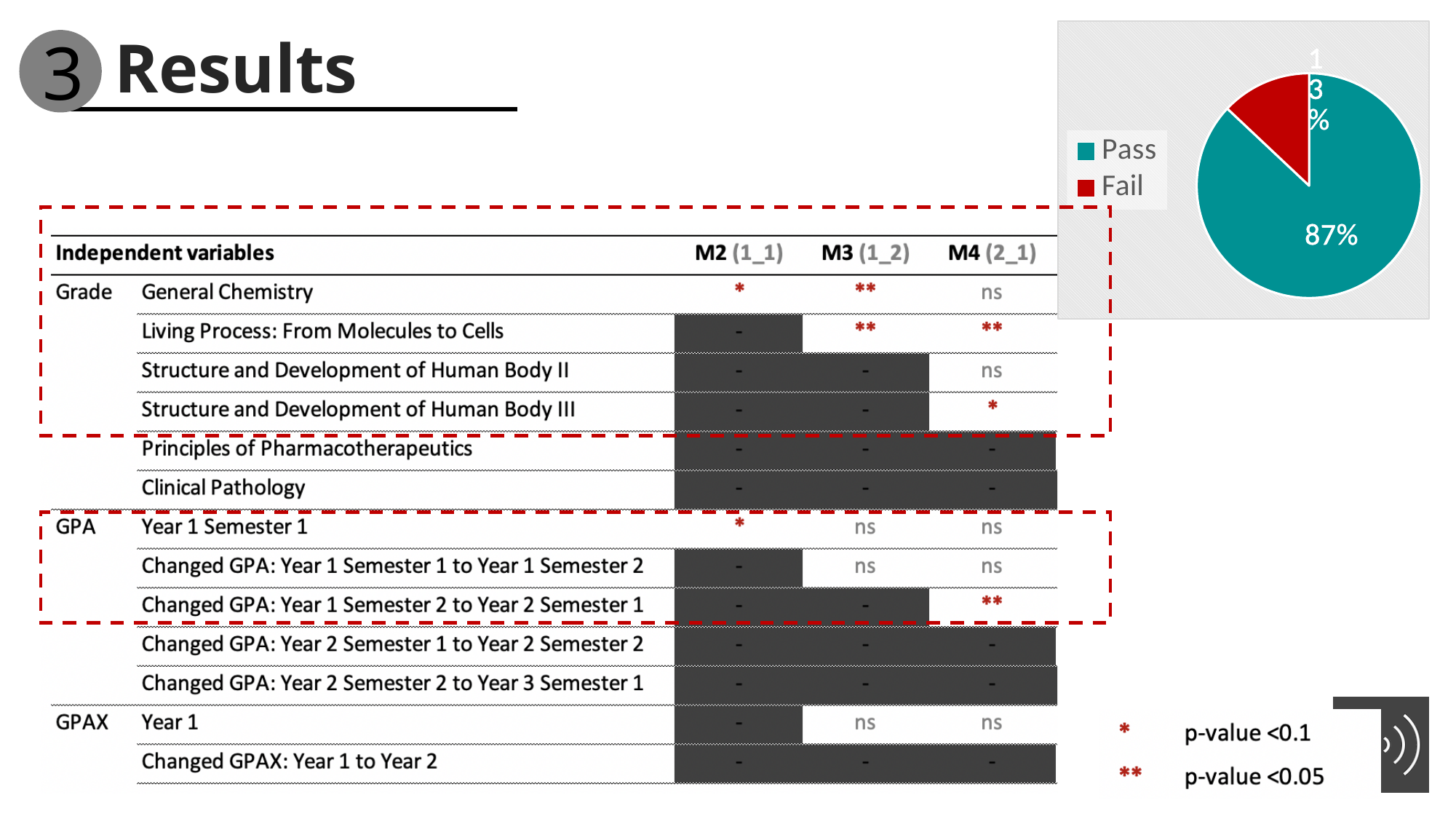
In the pie chart, what share of the pie is Pass? 87% In the pie chart, what is the difference in percentage points between Pass and Fail? 74 In the pie chart, which is larger, Pass or Fail? Pass How many entries does the pie chart's legend list? 2 In the pie chart, which slice is the largest? Pass In the pie chart, what colour is the Fail slice? red In the pie chart, which slice is the smallest? Fail In the pie chart, what colour is the Pass slice? teal In the pie chart, what share of the pie is Fail? 13% How many slices does the pie chart have? 2 What kind of chart is shown in the top right of the slide? pie chart